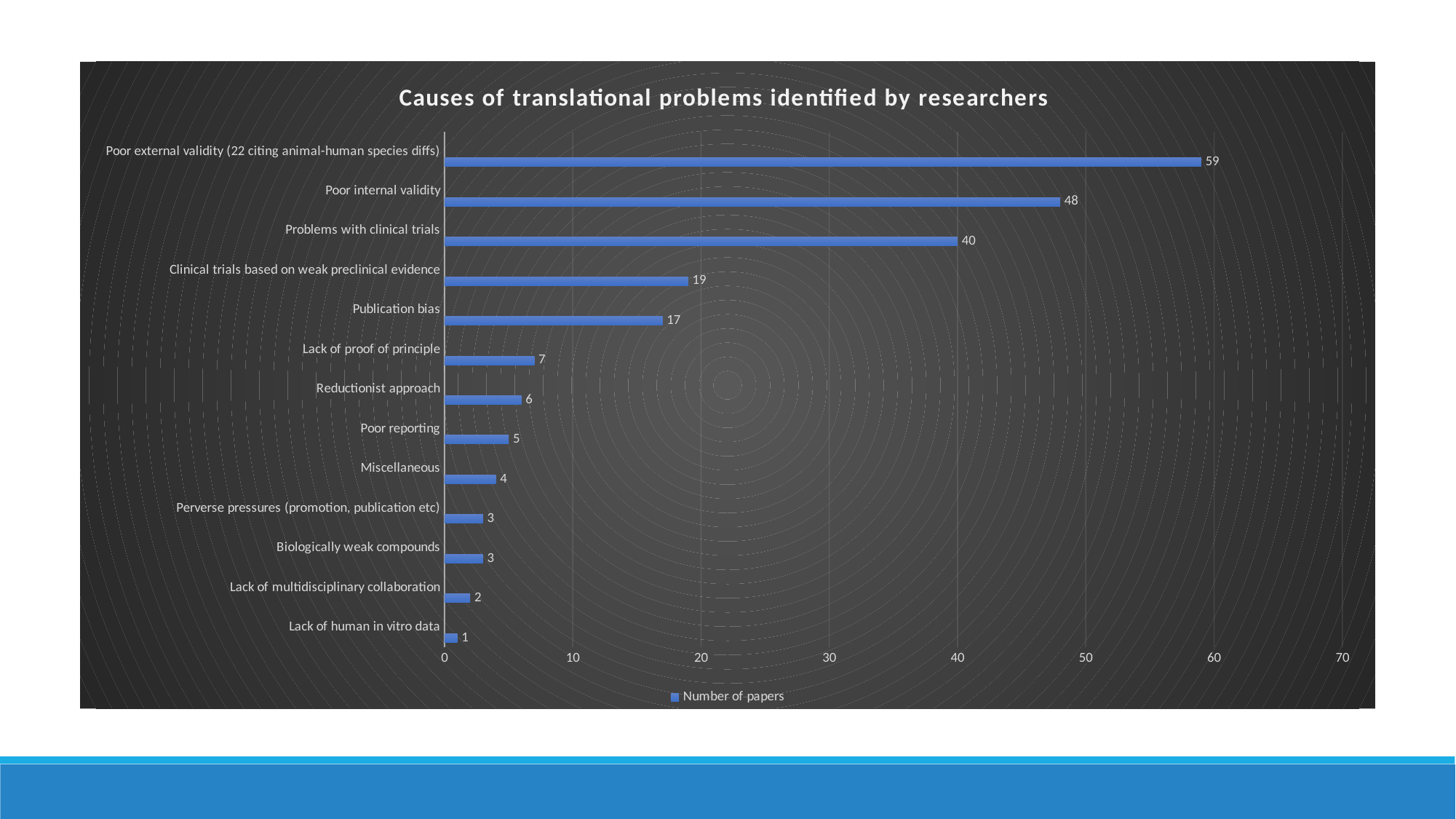
What kind of chart is shown on the slide? Bar chart Is the value for Problems with clinical trials greater or less than 30? greater Which cause has the highest number of papers? Poor external validity (22 citing animal-human species diffs) What is the title of the chart? Causes of translational problems identified by researchers How many series does the legend list? 1 What is the difference in number of papers between Poor internal validity and Problems with clinical trials? 8 What is the number of papers for Lack of multidisciplinary collaboration? 2 What is the number of papers for Poor internal validity? 48 Which has more papers, Clinical trials based on weak preclinical evidence or Publication bias? Clinical trials based on weak preclinical evidence What is the number of papers for Publication bias? 17 Which cause has the lowest number of papers? Lack of human in vitro data How many causes are listed on the chart? 13